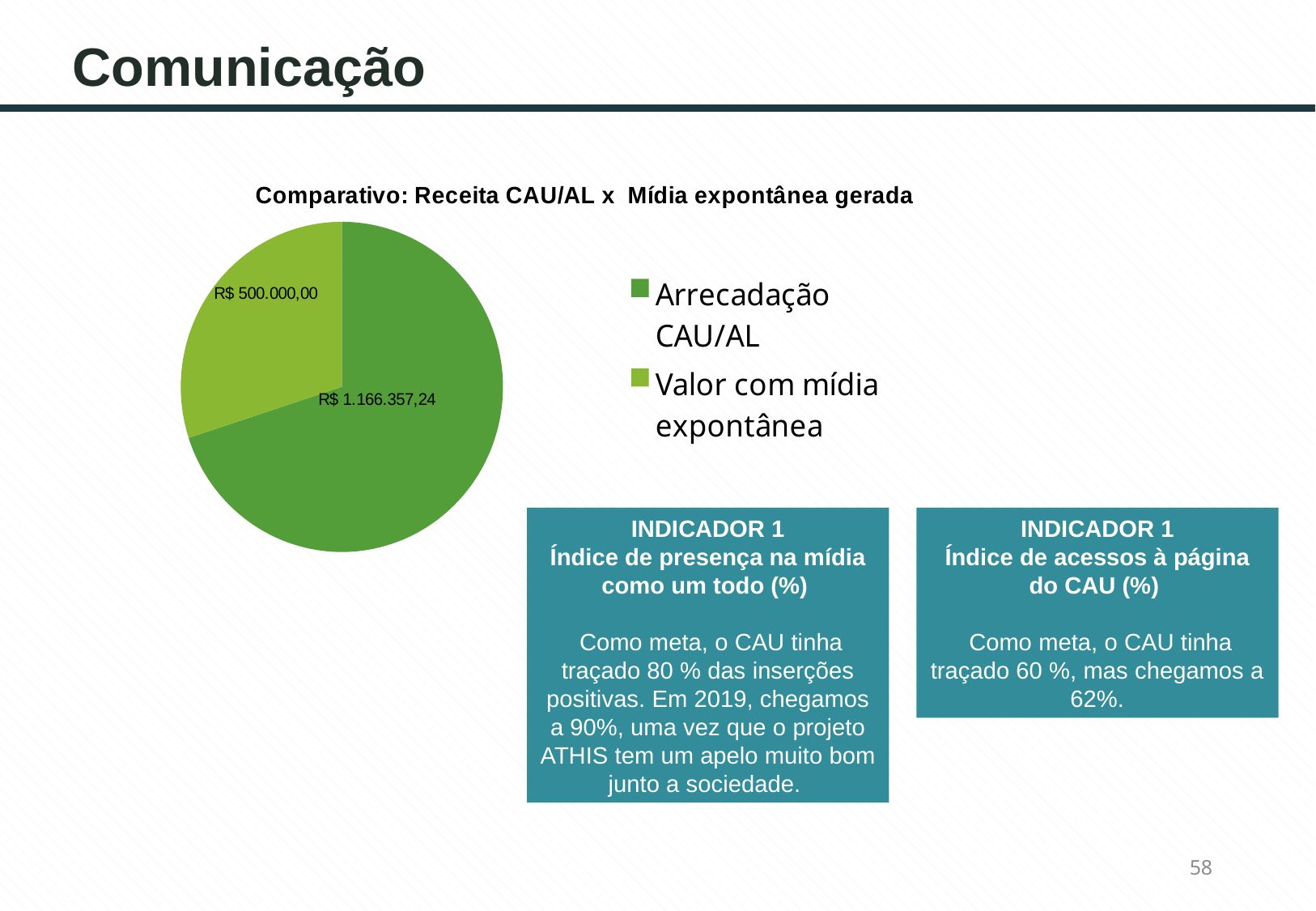
Which is larger, Arrecadação CAU/AL or Valor com mídia expontânea? Arrecadação CAU/AL How many slices does the pie chart have? 2 What is the value for Valor com mídia expontânea? R$ 500.000,00 What is the difference between Arrecadação CAU/AL and Valor com mídia expontânea? R$ 666.357,24 Which legend entry is shown in the lighter green colour? Valor com mídia expontânea What is the title of the chart? Comparativo: Receita CAU/AL x Mídia expontânea gerada Which slice is the largest in the pie chart? Arrecadação CAU/AL What is the total of the two values in the pie chart? R$ 1.666.357,24 What type of chart is shown on the slide? pie chart Which slice is the smallest in the pie chart? Valor com mídia expontânea What is the value for Arrecadação CAU/AL? R$ 1.166.357,24